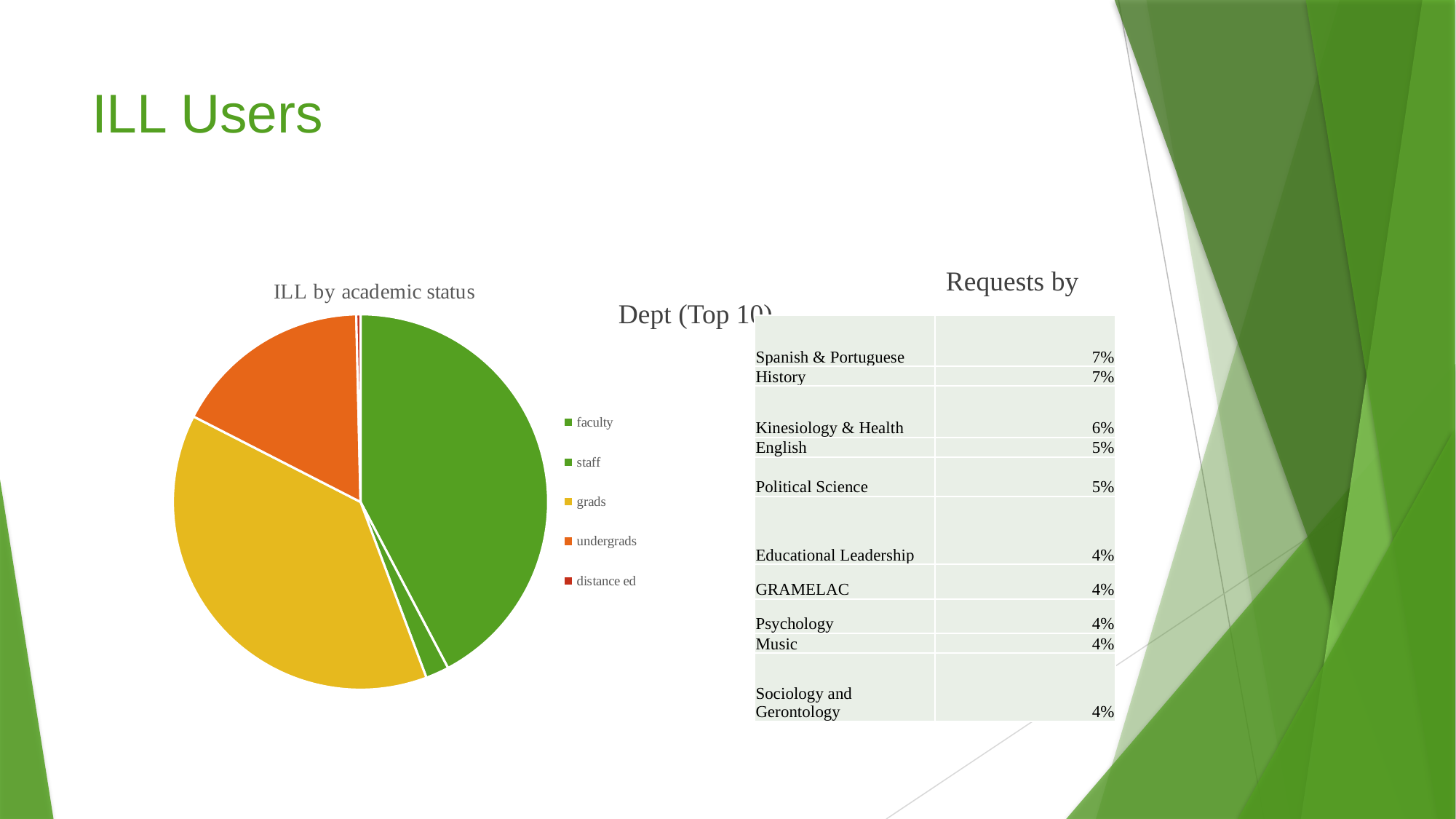
In the "ILL by academic status" pie chart, what colour is the grads slice? yellow In the "ILL by academic status" pie chart, which category has the smallest slice? distance ed In the "ILL by academic status" pie chart, which slice is larger: staff or distance ed? staff What is the title of the pie chart on the left of the slide? ILL by academic status In the "ILL by academic status" pie chart, which slice is larger: grads or undergrads? grads What kind of chart is the "ILL by academic status" chart? pie chart In the "ILL by academic status" pie chart, which category has the largest slice? faculty How many categories does the legend of the "ILL by academic status" pie chart list? 5 In the "ILL by academic status" pie chart, which slice is larger: undergrads or staff? undergrads How many slices does the "ILL by academic status" pie chart have? 5